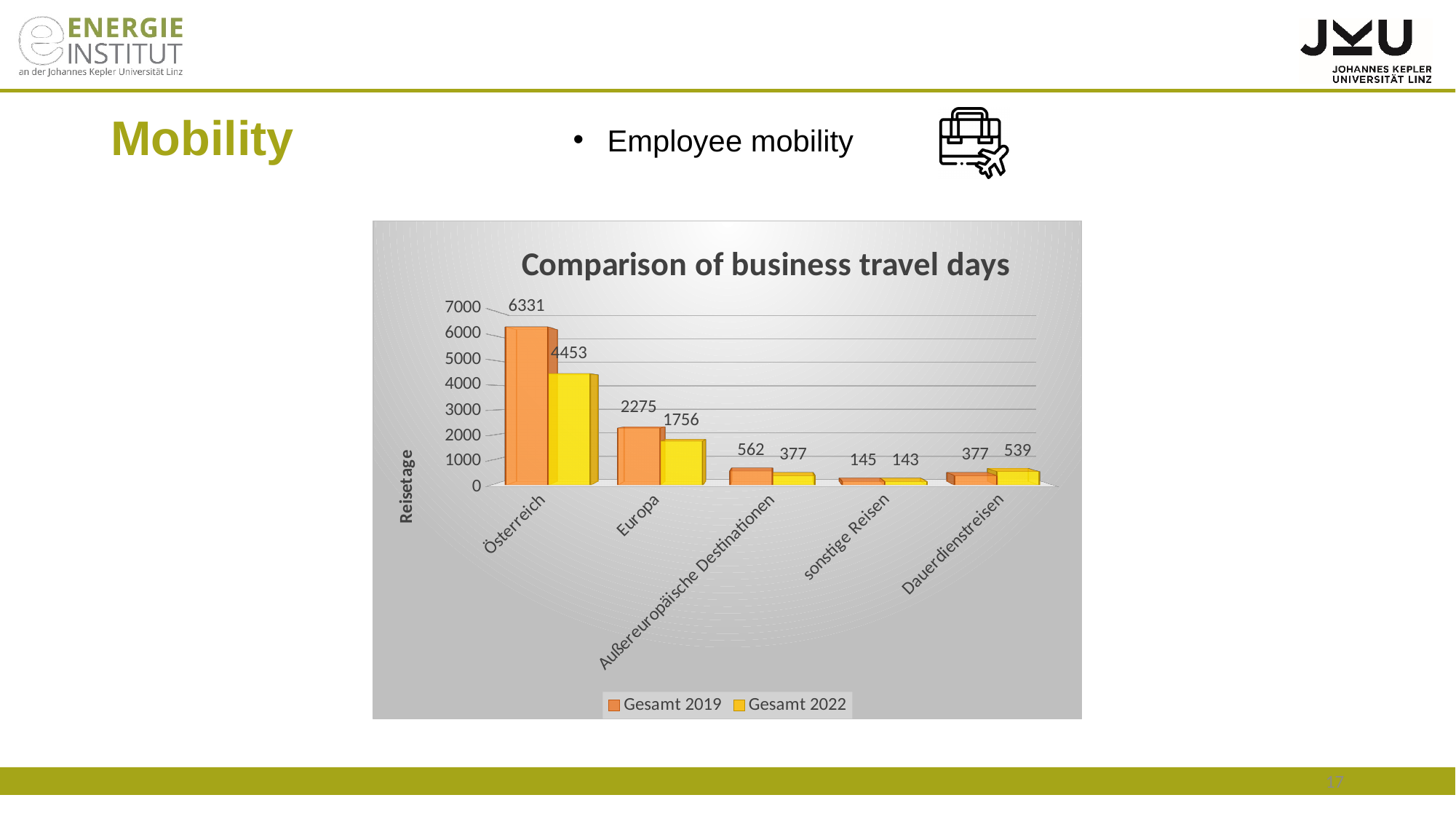
What kind of chart is shown on the slide? Bar chart Which category has the highest value in the Gesamt 2019 series? Österreich What is the value for Dauerdienstreisen in the Gesamt 2022 series? 539 What is the value for Österreich in the Gesamt 2019 series? 6331 Which is larger for Dauerdienstreisen: the Gesamt 2019 value or the Gesamt 2022 value? Gesamt 2022 What is the label of the vertical axis? Reisetage What is the value for Europa in the Gesamt 2022 series? 1756 How many categories are shown on the x axis? 5 How many series does the legend list? 2 Which category has the lowest value in the Gesamt 2022 series? sonstige Reisen What is the title of the chart? Comparison of business travel days What is the difference between the Gesamt 2019 and Gesamt 2022 values for Österreich? 1878